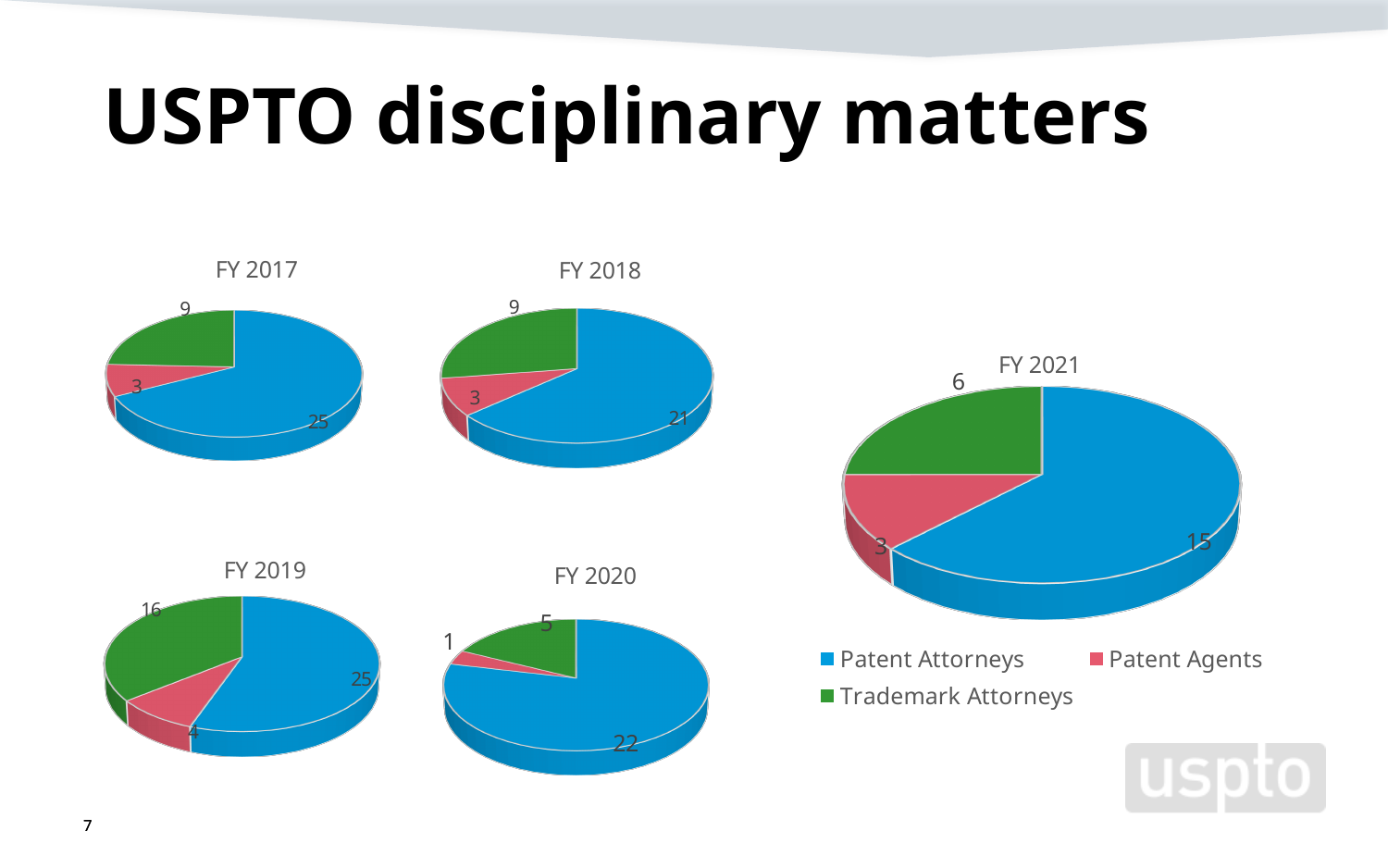
In the FY 2019 chart, what is the difference between the Patent Attorneys value and the Trademark Attorneys value? 9 What share of the FY 2020 chart does the Trademark Attorneys slice represent? 5 out of 28 In the FY 2018 chart, what is the value for Trademark Attorneys? 9 How many pie charts are shown on the slide? 5 In the FY 2020 chart, what is the value for Patent Agents? 1 In the FY 2021 chart, which category has the largest slice? Patent Attorneys In the FY 2019 chart, which category has the smallest slice? Patent Agents In the FY 2017 chart, what is the value for Patent Attorneys? 25 In the FY 2019 chart, what is the value for Patent Agents? 4 How many categories does the legend list? 3 What is the total of all slices in the FY 2021 chart? 24 Is the Patent Attorneys value larger in the FY 2018 chart or the FY 2020 chart? FY 2020